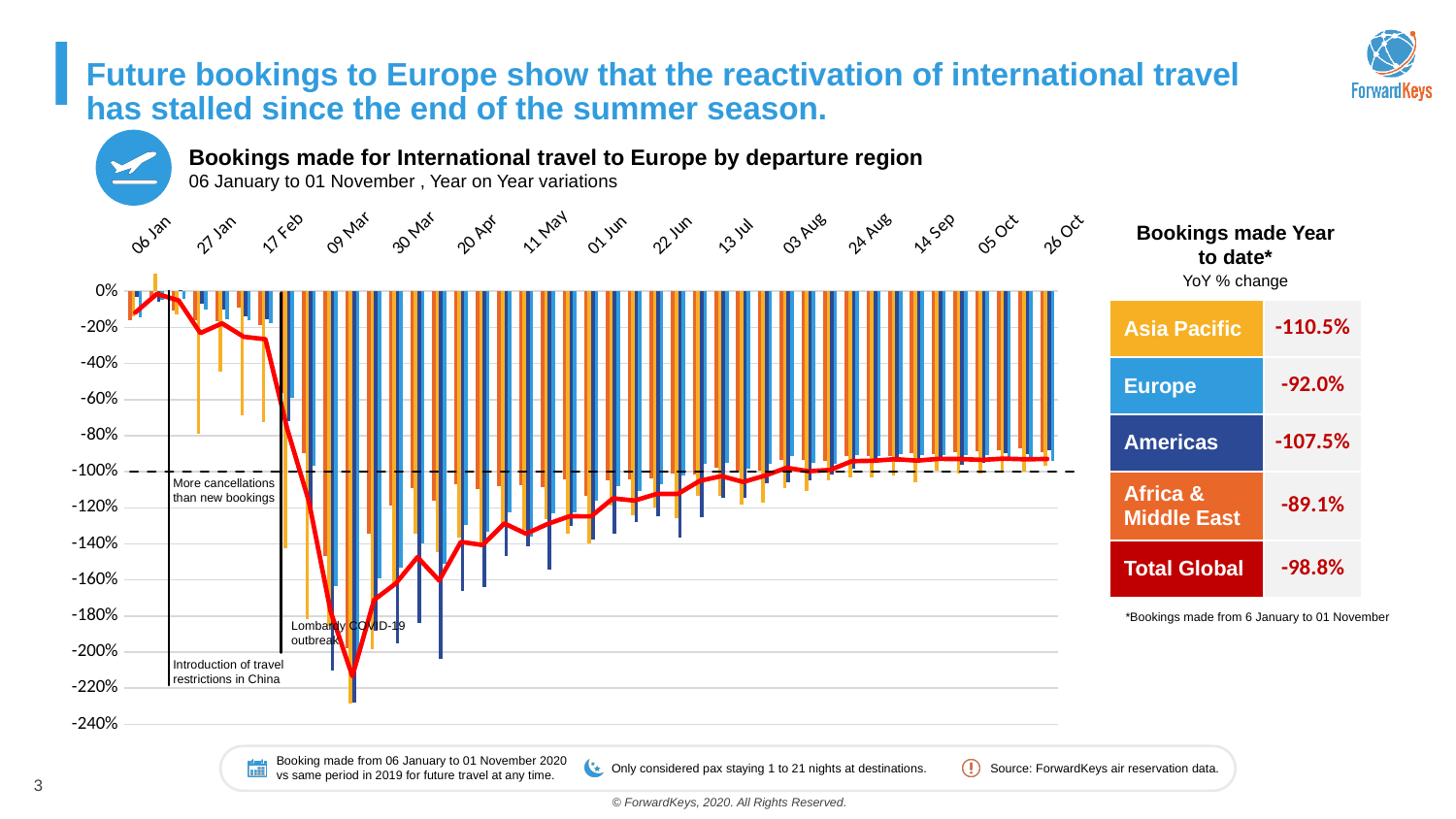
In the 'Bookings made Year to date' panel, what is the YoY % change for Total Global? -98.8% What kind of chart is shown on the slide? combination bar and line chart How many date labels are shown along the x axis of the chart? 15 On the chart, is the red line value at 09 Mar greater or less than -200%? greater What is the title of the chart? Bookings made for International travel to Europe by departure region In the 'Bookings made Year to date' panel, what is the YoY % change for Europe? -92.0% In the 'Bookings made Year to date' panel, which is higher, the value for Europe or the value for Americas? Europe In the 'Bookings made Year to date' panel, which region has the lowest (most negative) YoY % change? Asia Pacific In the 'Bookings made Year to date' panel, what is the YoY % change for Asia Pacific? -110.5% On the chart, is the red line value at 26 Oct greater or less than -100%? greater In the 'Bookings made Year to date' panel, what is the difference in percentage points between the Europe value (-92.0%) and the Americas value (-107.5%)? 15.5 percentage points In the 'Bookings made Year to date' panel, which region has the highest (least negative) YoY % change? Africa & Middle East